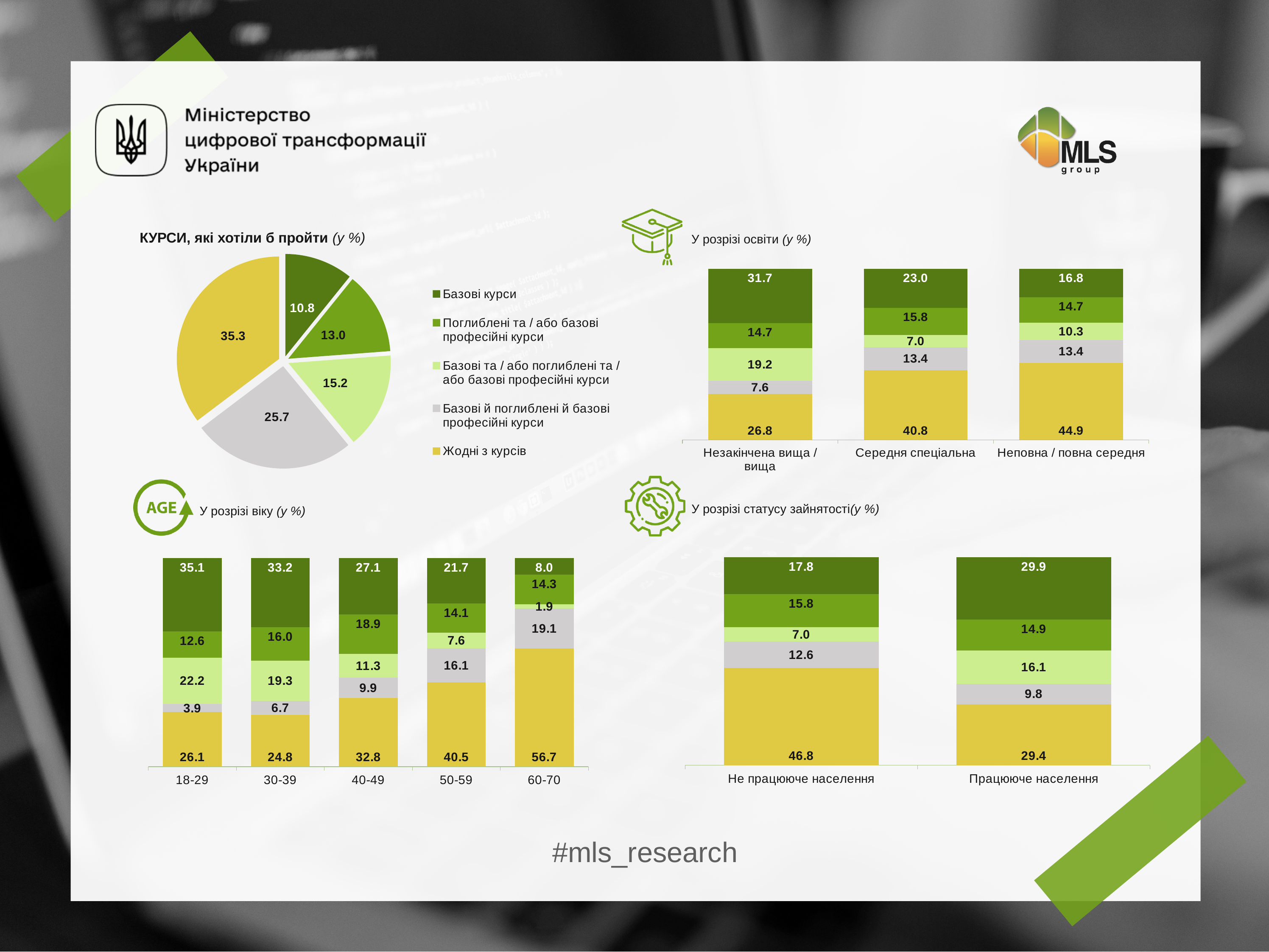
In the chart 'У розрізі віку', how many age groups are shown? 5 In the chart 'У розрізі освіти', what is the value of the yellow 'Жодні з курсів' segment for 'Неповна / повна середня'? 44.9 In the chart 'У розрізі віку', what is the difference in the 'Базові курси' (dark green) value between the 18-29 and 60-70 age groups? 27.1 In the pie chart 'КУРСИ, які хотіли б пройти', which category has the largest slice? Жодні з курсів In the pie chart 'КУРСИ, які хотіли б пройти', what is the difference between the 'Жодні з курсів' slice and the 'Базові й поглиблені й базові професійні курси' slice? 9.6 In the chart 'У розрізі статусу зайнятості', which group has the larger dark green 'Базові курси' value, 'Не працююче населення' or 'Працююче населення'? Працююче населення In the chart 'У розрізі віку', does the dark green 'Базові курси' segment rise or fall as age increases from 18-29 to 60-70? fall In the pie chart 'КУРСИ, які хотіли б пройти', what is the value for 'Жодні з курсів'? 35.3 In the chart 'У розрізі статусу зайнятості', what is the value of the yellow 'Жодні з курсів' segment for 'Не працююче населення'? 46.8 In the pie chart 'КУРСИ, які хотіли б пройти', how many slices are there? 5 In the chart 'У розрізі освіти', which education group has the highest value for the dark green 'Базові курси' segment? Незакінчена вища / вища In the chart 'У розрізі віку', what is the value of the yellow 'Жодні з курсів' segment for the 60-70 age group? 56.7